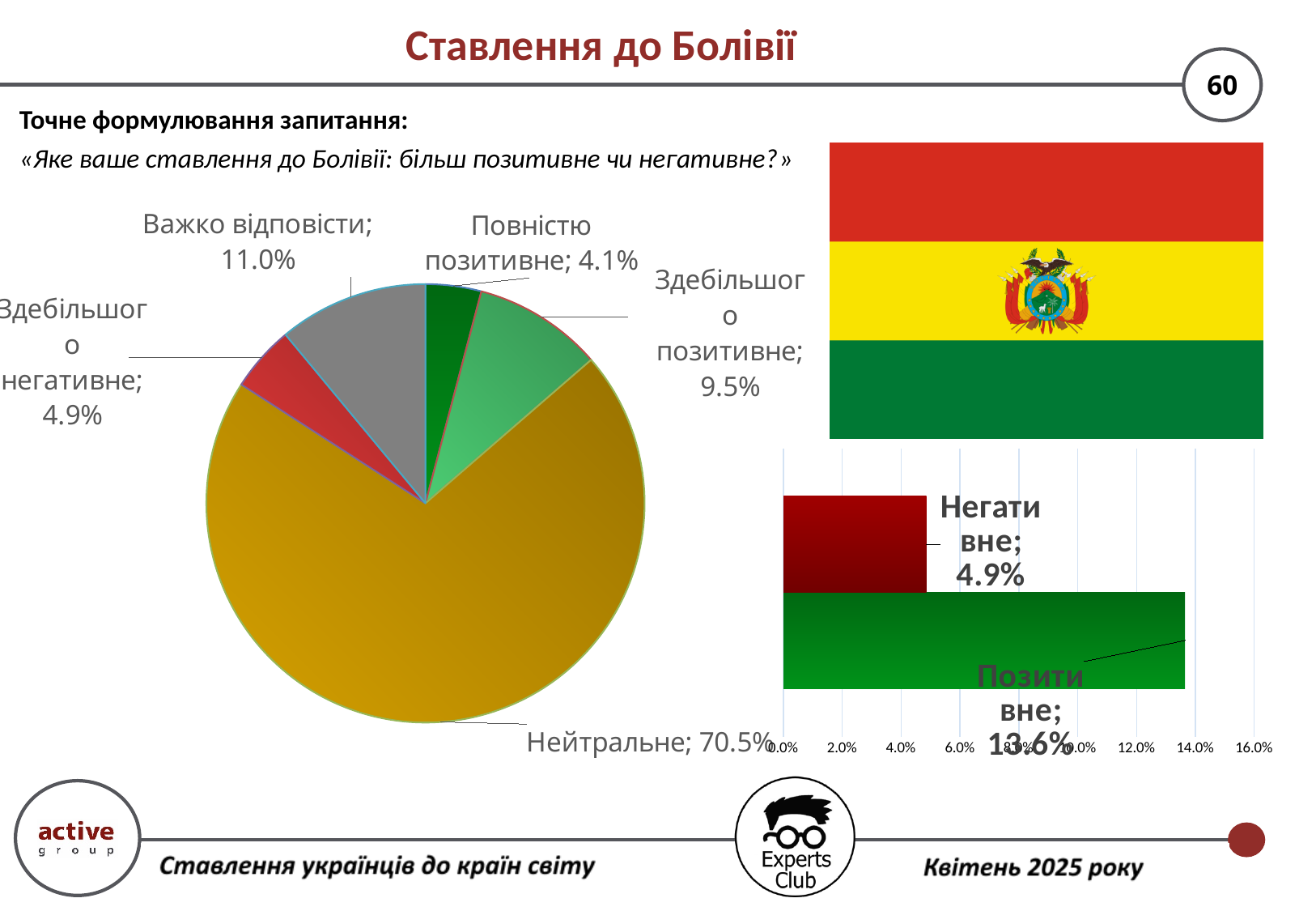
In the pie chart, what is the value for Важко відповісти? 11.0% What type of chart is shown on the left of the slide? pie chart In the pie chart, how many slices are there? 5 In the pie chart, which category has the largest share? Нейтральне In the pie chart, what share is labelled for Нейтральне? 70.5% In the bar chart on the right, what is the value for Негативне? 4.9% In the pie chart, what is the value for Здебільшого позитивне? 9.5% In the bar chart on the right, which is larger, Позитивне or Негативне? Позитивне In the bar chart on the right, what is the value for Позитивне? 13.6% In the pie chart, what is the difference between Важко відповісти and Здебільшого позитивне? 1.5% In the pie chart, which category has the smallest share? Повністю позитивне In the pie chart, what is the value for Повністю позитивне? 4.1%